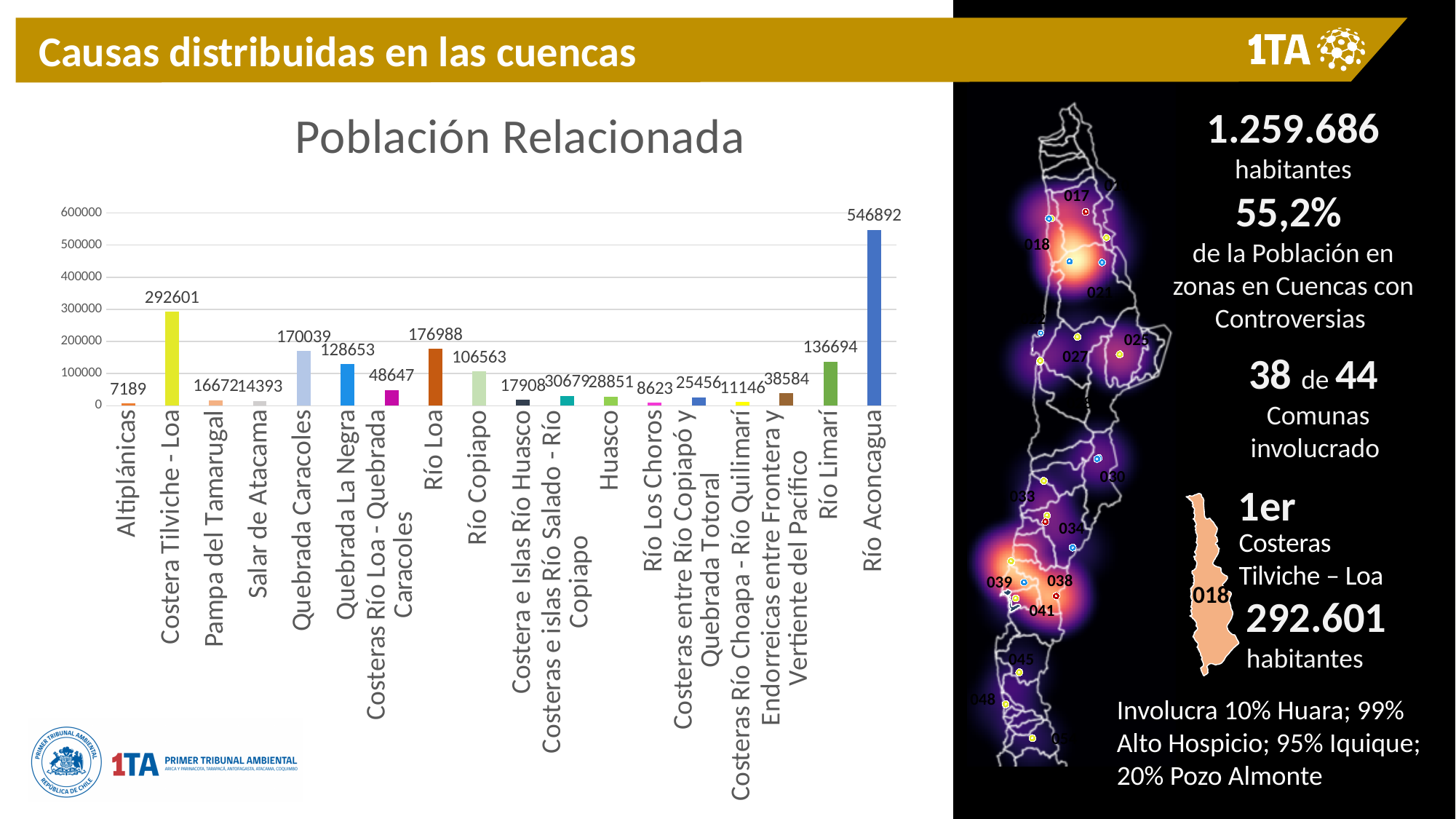
What is the difference between the values for Río Limarí and Río Copiapo in the Población Relacionada chart? 30131 Is the value for Río Aconcagua in the Población Relacionada chart greater or less than 500000? greater What is the value for Costera Tilviche - Loa in the Población Relacionada chart? 292601 What is the value for Río Aconcagua in the Población Relacionada chart? 546892 What is the value for Río Limarí in the Población Relacionada chart? 136694 What is the difference between the values for Río Aconcagua and Costera Tilviche - Loa in the Población Relacionada chart? 254291 Which is larger in the Población Relacionada chart, Quebrada La Negra or Río Limarí? Río Limarí How many categories are shown in the Población Relacionada chart? 18 Which category has the highest value in the Población Relacionada chart? Río Aconcagua Which category has the lowest value in the Población Relacionada chart? Altiplánicas What kind of chart is the Población Relacionada chart? bar chart What is the value for Quebrada La Negra in the Población Relacionada chart? 128653